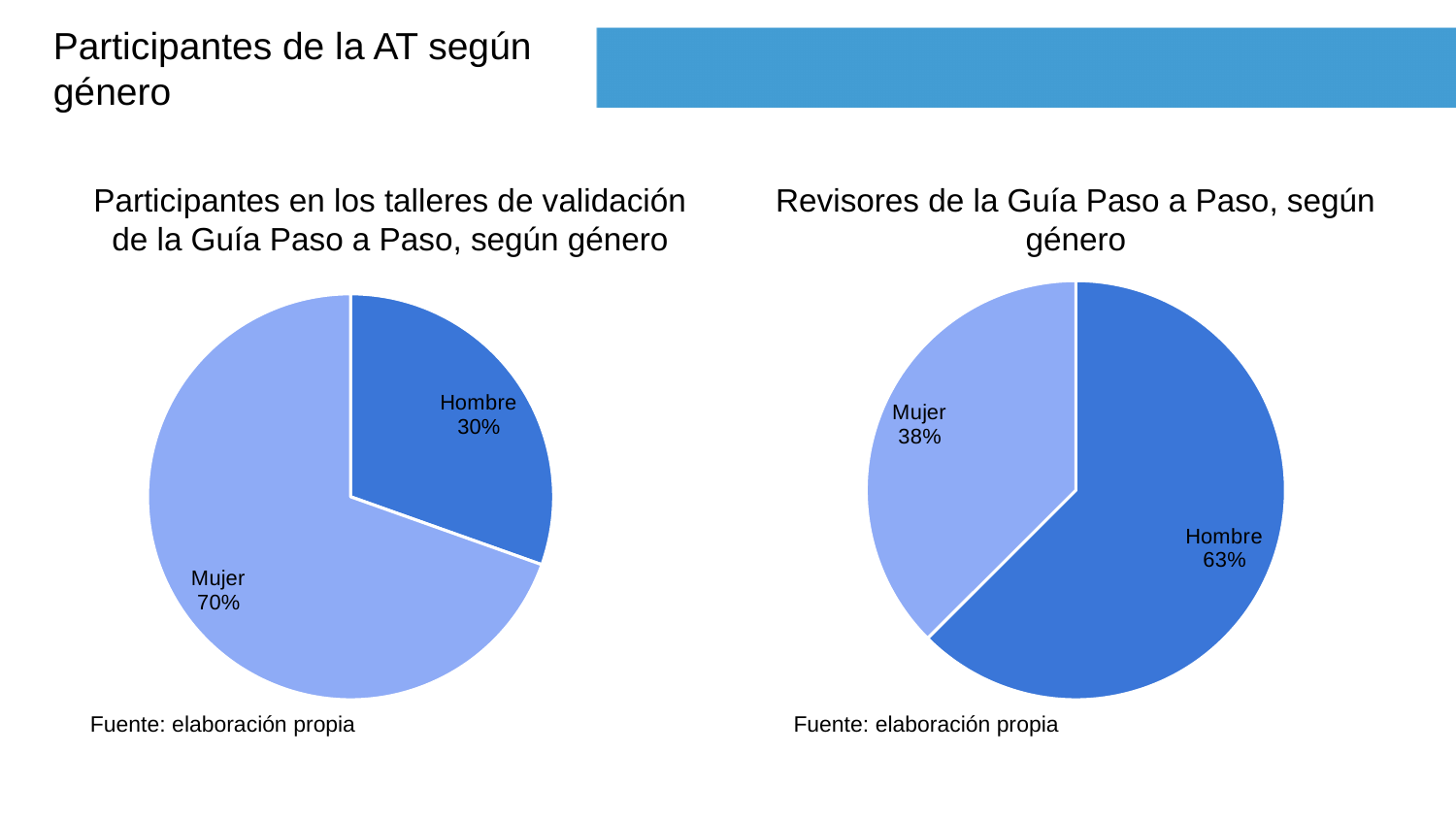
In the left chart (Participantes en los talleres de validación), which category has the largest slice? Mujer In the right chart (Revisores de la Guía Paso a Paso), which category has the smallest slice? Mujer What is the title of the chart on the right of the slide? Revisores de la Guía Paso a Paso, según género In the left chart (Participantes en los talleres de validación), what is the difference in percentage points between Mujer and Hombre? 40 percentage points What type of chart is used on the left of the slide? Pie chart In the right chart (Revisores de la Guía Paso a Paso), which is larger, Hombre or Mujer? Hombre In the right chart (Revisores de la Guía Paso a Paso, según género), what share is Hombre? 63% In the right chart (Revisores de la Guía Paso a Paso), what share is Mujer? 38% In the right chart (Revisores de la Guía Paso a Paso), what is the difference in percentage points between Hombre and Mujer? 25 percentage points In the left chart (Participantes en los talleres de validación), what share is Hombre? 30% How many slices does the right chart (Revisores de la Guía Paso a Paso) have? 2 In the left chart (Participantes en los talleres de validación de la Guía Paso a Paso, según género), what share is Mujer? 70%